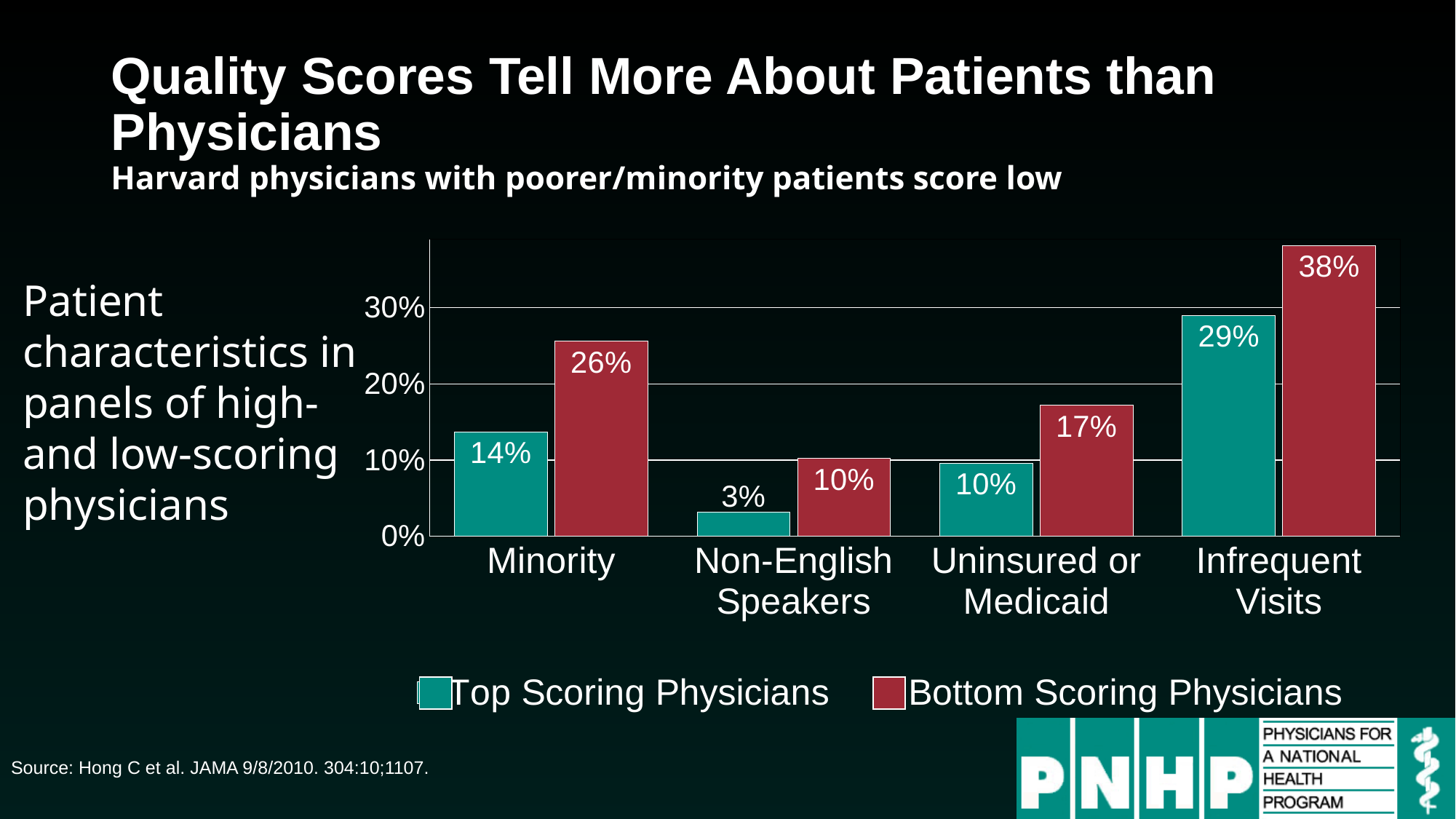
Which is larger in the Uninsured or Medicaid category: Top Scoring Physicians or Bottom Scoring Physicians? Bottom Scoring Physicians What kind of chart is shown on the slide? Bar chart What is the value for Top Scoring Physicians in the Minority category? 14% Which category has the lowest value for Top Scoring Physicians? Non-English Speakers What is the value for Bottom Scoring Physicians in the Uninsured or Medicaid category? 17% What is the difference between Bottom Scoring Physicians and Top Scoring Physicians in the Minority category? 12% How many categories are shown on the x axis? 4 Which category has the highest value for Bottom Scoring Physicians? Infrequent Visits What is the value for Bottom Scoring Physicians in the Infrequent Visits category? 38% What colour are the bars for Bottom Scoring Physicians? Red How many series does the legend list? 2 What is the value for Top Scoring Physicians in the Non-English Speakers category? 3%